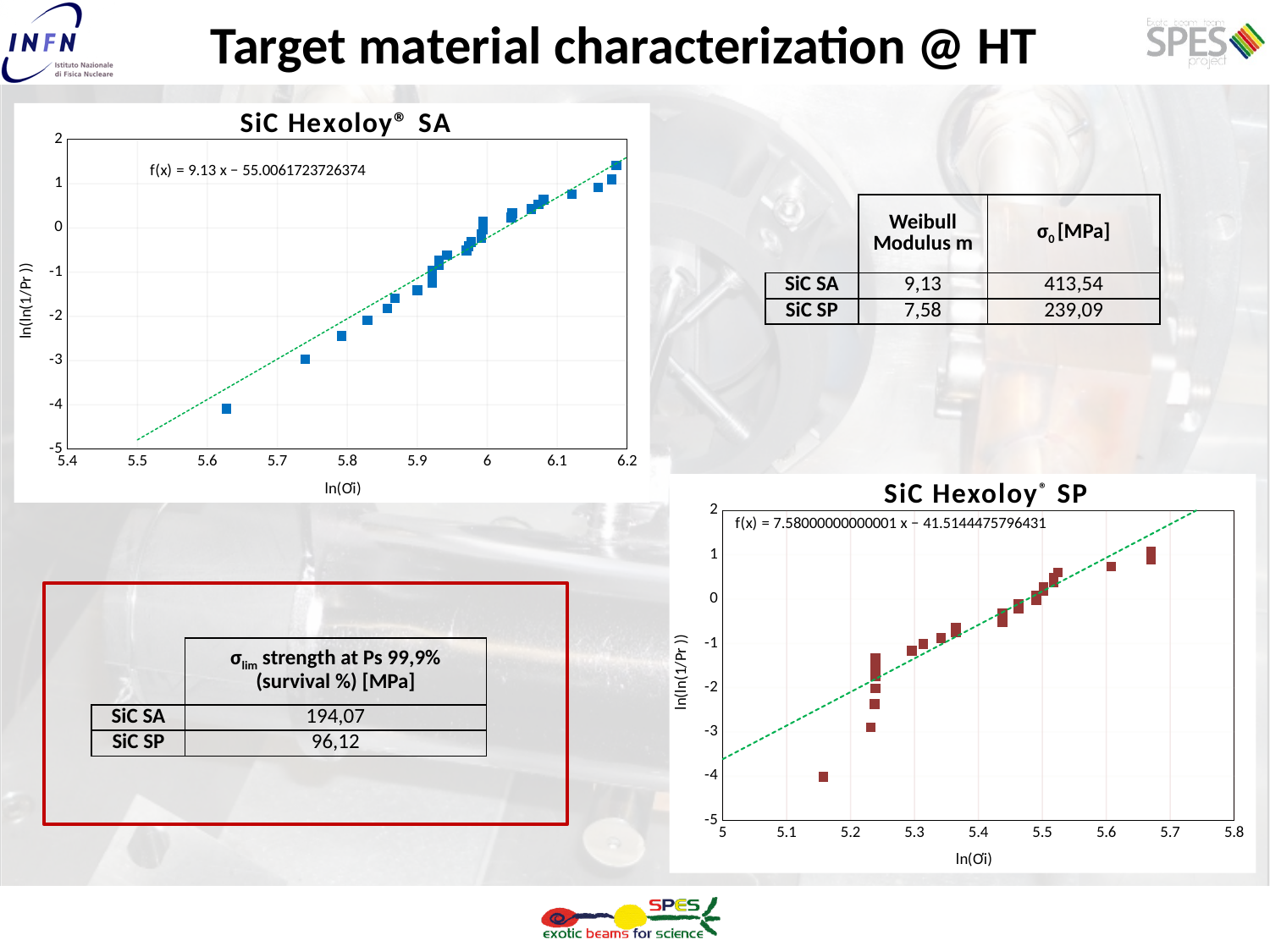
What is the difference between the fitted line slope in the "SiC Hexoloy SA" chart (9.13) and the slope in the "SiC Hexoloy SP" chart (7.58)? 1.55 In the "SiC Hexoloy SP" chart, what is the intercept of the fitted line f(x)? − 41.5144475796431 In the "SiC Hexoloy SA" chart, is the value of the point near ln(σi) = 5.8 greater or less than -2? less Which chart has the steeper fitted line slope, "SiC Hexoloy SA" or "SiC Hexoloy SP"? SiC Hexoloy SA In the "SiC Hexoloy SP" chart, is the value of the rightmost point (near ln(σi) = 5.67) greater or less than 0? greater In the "SiC Hexoloy SA" chart, what is the slope of the fitted line f(x)? 9.13 In the "SiC Hexoloy SA" chart, do the plotted points rise or fall as ln(σi) increases? Rise What type of chart is the "SiC Hexoloy SA" chart? Scatter chart What is the x-axis label of the "SiC Hexoloy SP" chart? ln(σi) What type of chart is the "SiC Hexoloy SP" chart? Scatter chart In the "SiC Hexoloy SA" chart, what is the intercept of the fitted line f(x)? − 55.0061723726374 In the "SiC Hexoloy SP" chart, do the plotted points rise or fall along the x axis? Rise